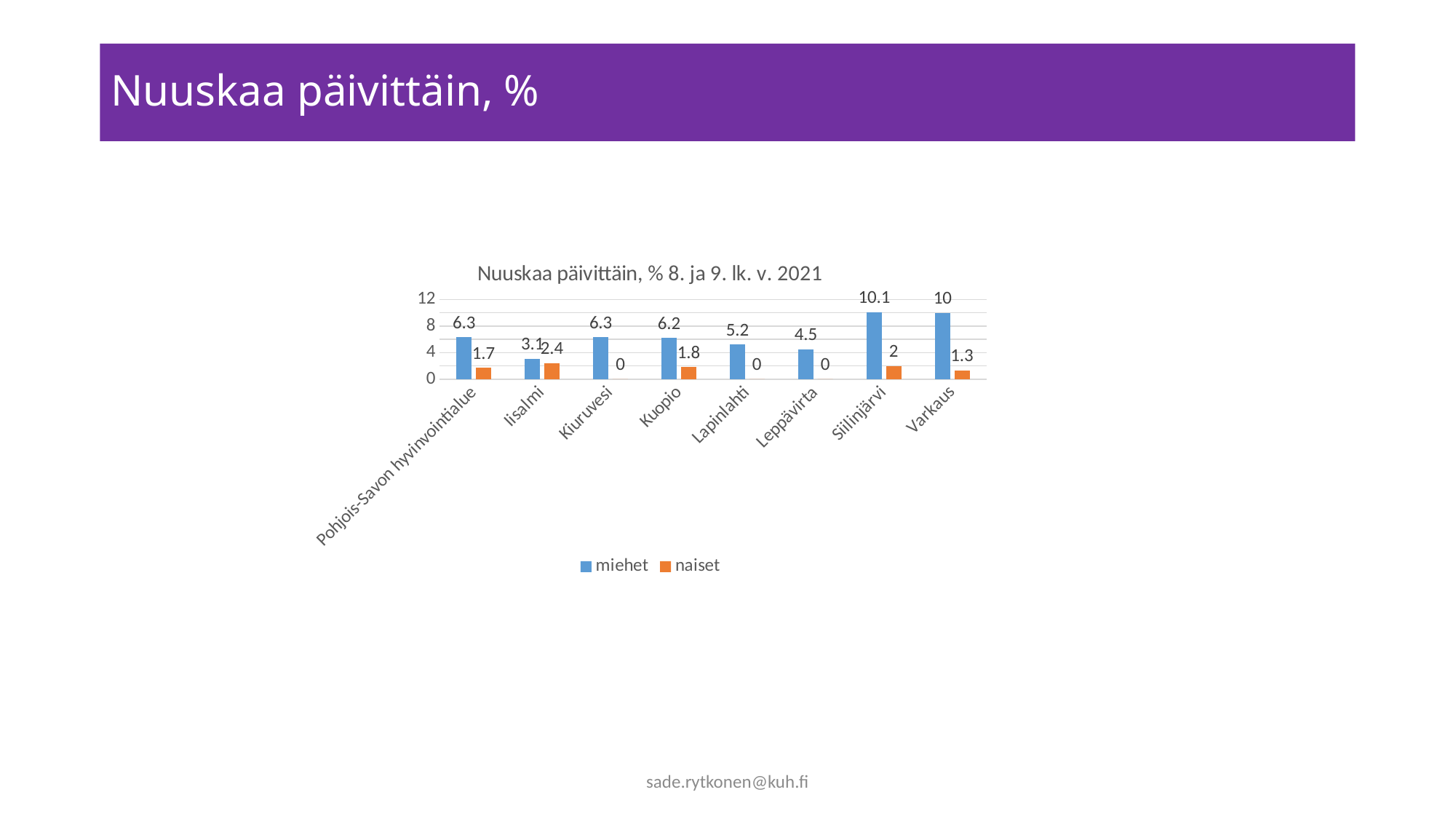
What is the naiset value for Iisalmi? 2.4 What is the naiset value for Kiuruvesi? 0 Which is larger, the miehet value for Lapinlahti or the miehet value for Leppävirta? Lapinlahti How many series does the legend list? 2 Which category has the lowest miehet value? Iisalmi What is the title of the chart? Nuuskaa päivittäin, % 8. ja 9. lk. v. 2021 Which category has the highest naiset value? Iisalmi How many categories are shown on the x axis? 8 What kind of chart is shown on the slide? Bar chart What is the difference between the miehet and naiset values for Varkaus? 8.7 What is the miehet value for Siilinjärvi? 10.1 What is the miehet value for Kuopio? 6.2